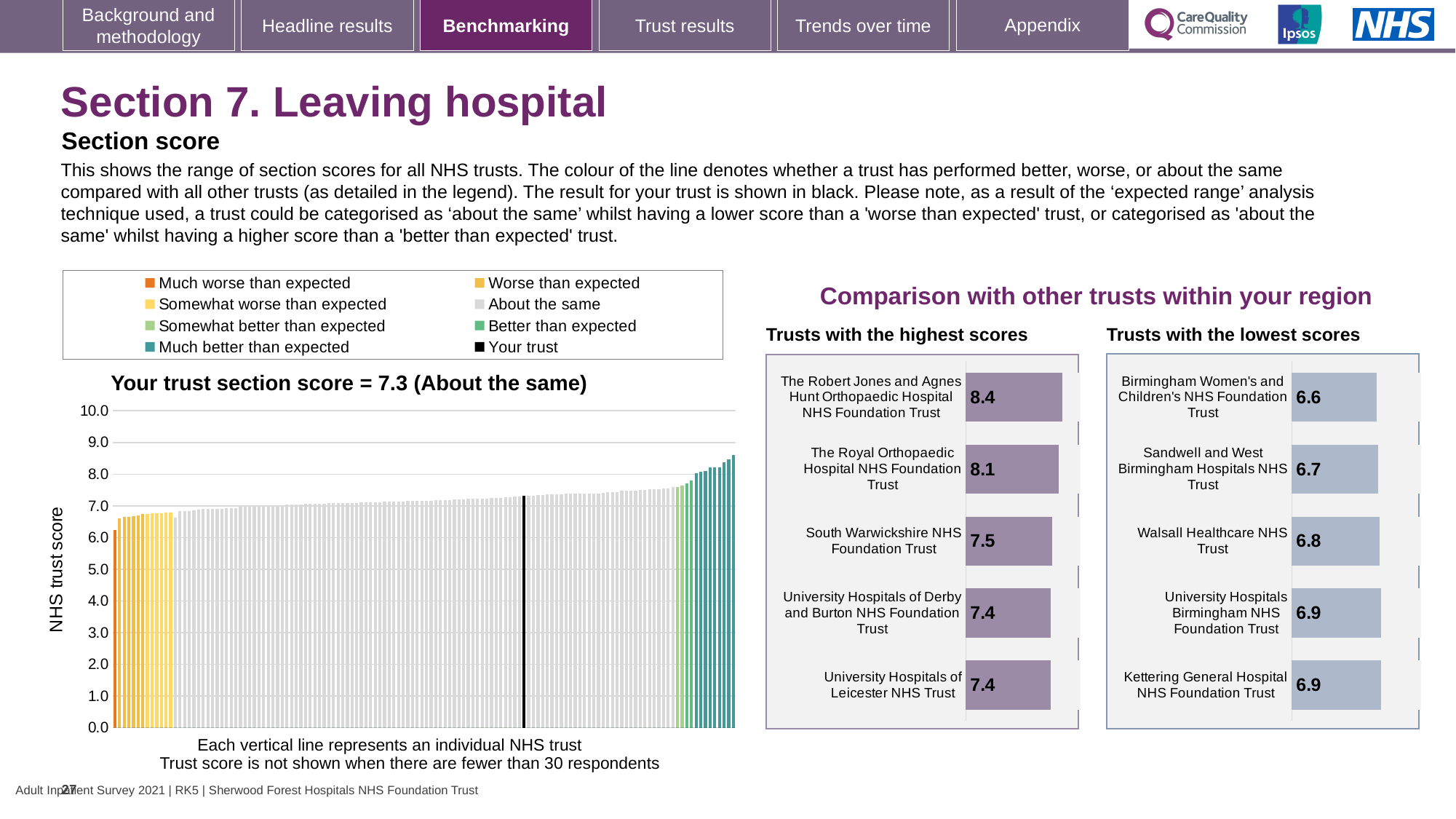
In the 'Your trust section score' chart, do the trust scores rise or fall from left to right? Rise In the 'Trusts with the highest scores' chart, how many trusts are shown? 5 In the 'Trusts with the lowest scores' chart, which has the larger score: Sandwell and West Birmingham Hospitals NHS Trust or Kettering General Hospital NHS Foundation Trust? Kettering General Hospital NHS Foundation Trust How many entries does the legend above the 'Your trust section score' chart list? 8 In the 'Trusts with the lowest scores' chart, what is the score for Walsall Healthcare NHS Trust? 6.8 In the 'Trusts with the lowest scores' chart, what is the difference between the scores of Walsall Healthcare NHS Trust and Birmingham Women's and Children's NHS Foundation Trust? 0.2 In the 'Your trust section score' chart, what is the section score for your trust? 7.3 In the 'Trusts with the lowest scores' chart, which trust has the lowest score? Birmingham Women's and Children's NHS Foundation Trust What kind of chart is the 'Your trust section score' chart? Bar chart In the 'Trusts with the highest scores' chart, what is the difference between the scores of The Robert Jones and Agnes Hunt Orthopaedic Hospital NHS Foundation Trust and South Warwickshire NHS Foundation Trust? 0.9 In the 'Trusts with the highest scores' chart, what is the score for The Royal Orthopaedic Hospital NHS Foundation Trust? 8.1 In the 'Trusts with the highest scores' chart, which trust has the highest score? The Robert Jones and Agnes Hunt Orthopaedic Hospital NHS Foundation Trust